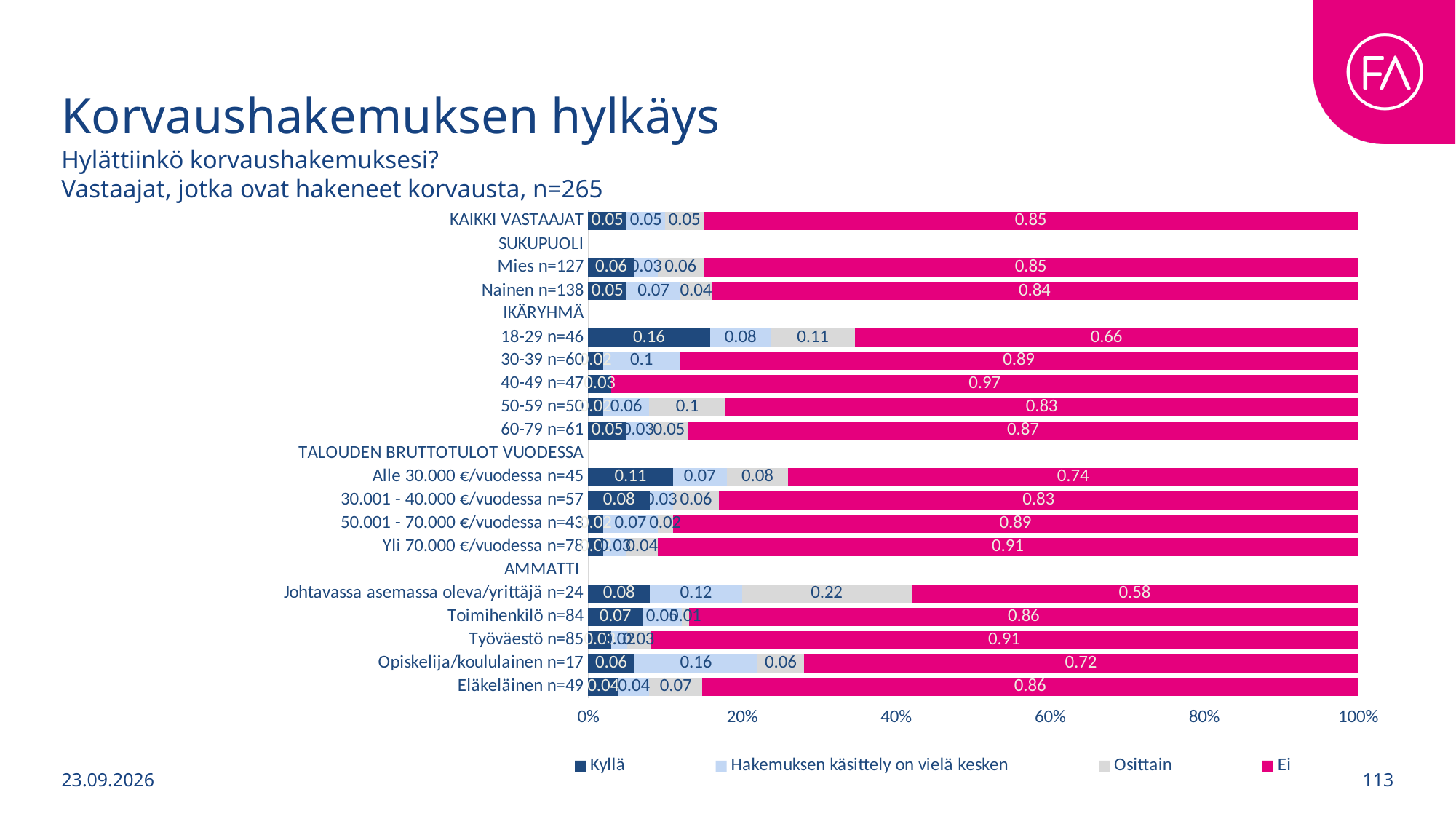
Which has a larger "Ei" value: Opiskelija/koululainen n=17 or Eläkeläinen n=49? Eläkeläinen n=49 Is the "Ei" value for Johtavassa asemassa oleva/yrittäjä n=24 greater or less than 60%? less What is the value of the "Osittain" series for Johtavassa asemassa oleva/yrittäjä n=24? 0.22 What is the value of the "Ei" series for KAIKKI VASTAAJAT? 0.85 What is the difference between the "Ei" value for 40-49 n=47 and the "Ei" value for 18-29 n=46? 0.31 Which category has the lowest value for the "Ei" series? Johtavassa asemassa oleva/yrittäjä n=24 What is the value of the "Kyllä" series for the 18-29 n=46 age group? 0.16 Which category has the highest value for the "Ei" series? 40-49 n=47 How many series does the legend list? 4 What is the value of the "Ei" series for Yli 70.000 €/vuodessa n=78? 0.91 What kind of chart is shown on the slide? Stacked bar chart What is the value of the "Hakemuksen käsittely on vielä kesken" series for Opiskelija/koululainen n=17? 0.16